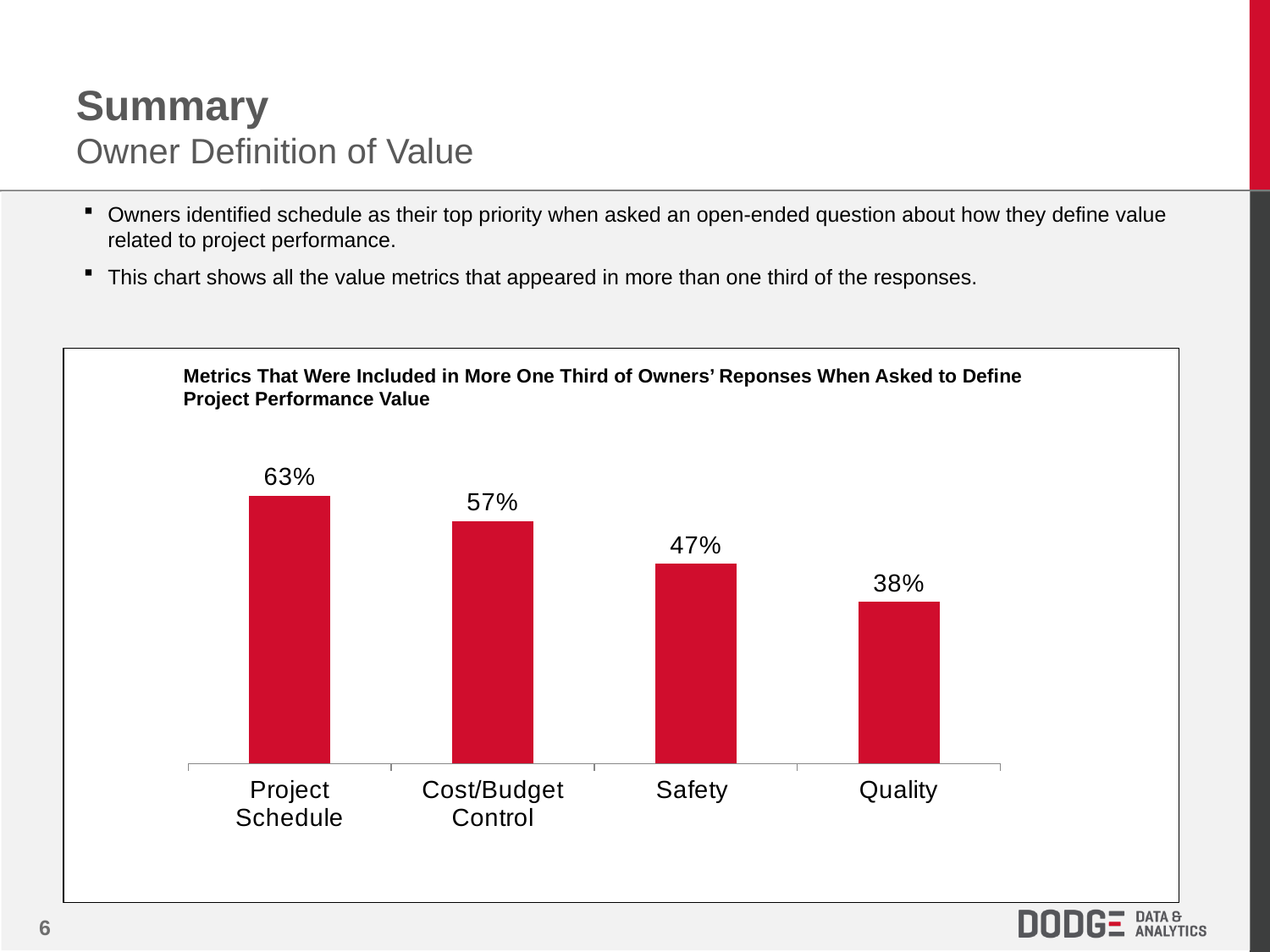
Which category has the highest value? Project Schedule What is the value for Quality? 38% How many categories are shown in the chart? 4 Which category has the lowest value? Quality What is the difference between the values for Project Schedule and Quality? 25% What is the value for Safety? 47% What kind of chart is shown on the slide? Bar chart Which is larger, the value for Safety or the value for Quality? Safety What is the difference between the values for Cost/Budget Control and Safety? 10% What is the value for Project Schedule? 63% Do the values rise or fall from left to right along the x axis? Fall What is the value for Cost/Budget Control? 57%